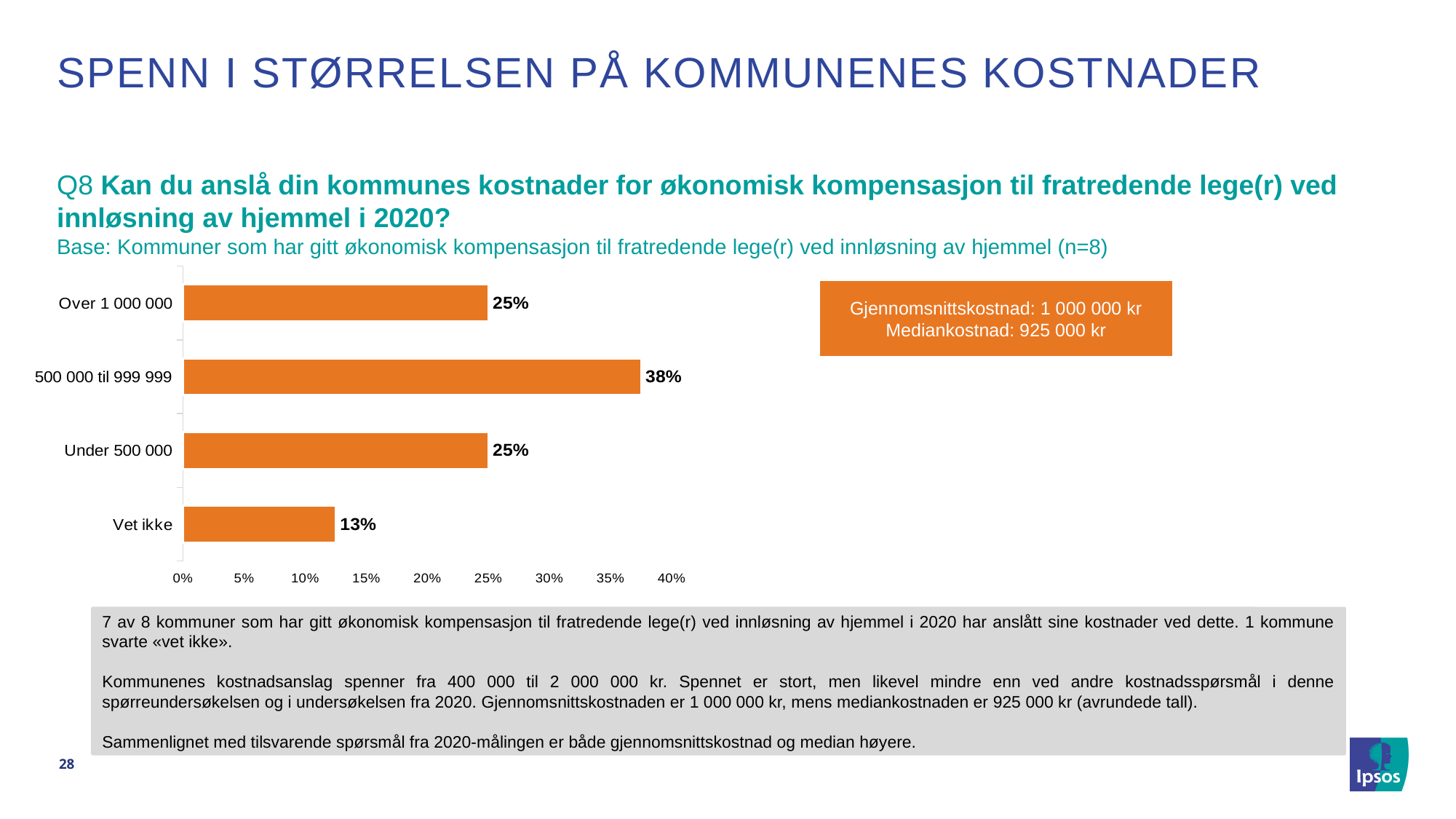
What is the value for "Under 500 000"? 25% Which category has the lowest value? Vet ikke What is the value for "Over 1 000 000"? 25% What is the value for "Vet ikke"? 13% What is the difference between the values for "500 000 til 999 999" and "Vet ikke"? 25 percentage points Which category has the highest value? 500 000 til 999 999 What median cost is stated in the orange box next to the chart? 925 000 kr How many categories are shown in the chart? 4 What kind of chart is shown on the slide? Bar chart Which is larger, the value for "500 000 til 999 999" or the value for "Under 500 000"? 500 000 til 999 999 What is the value for "500 000 til 999 999"? 38% Is the value for "Vet ikke" greater or less than 15%? less